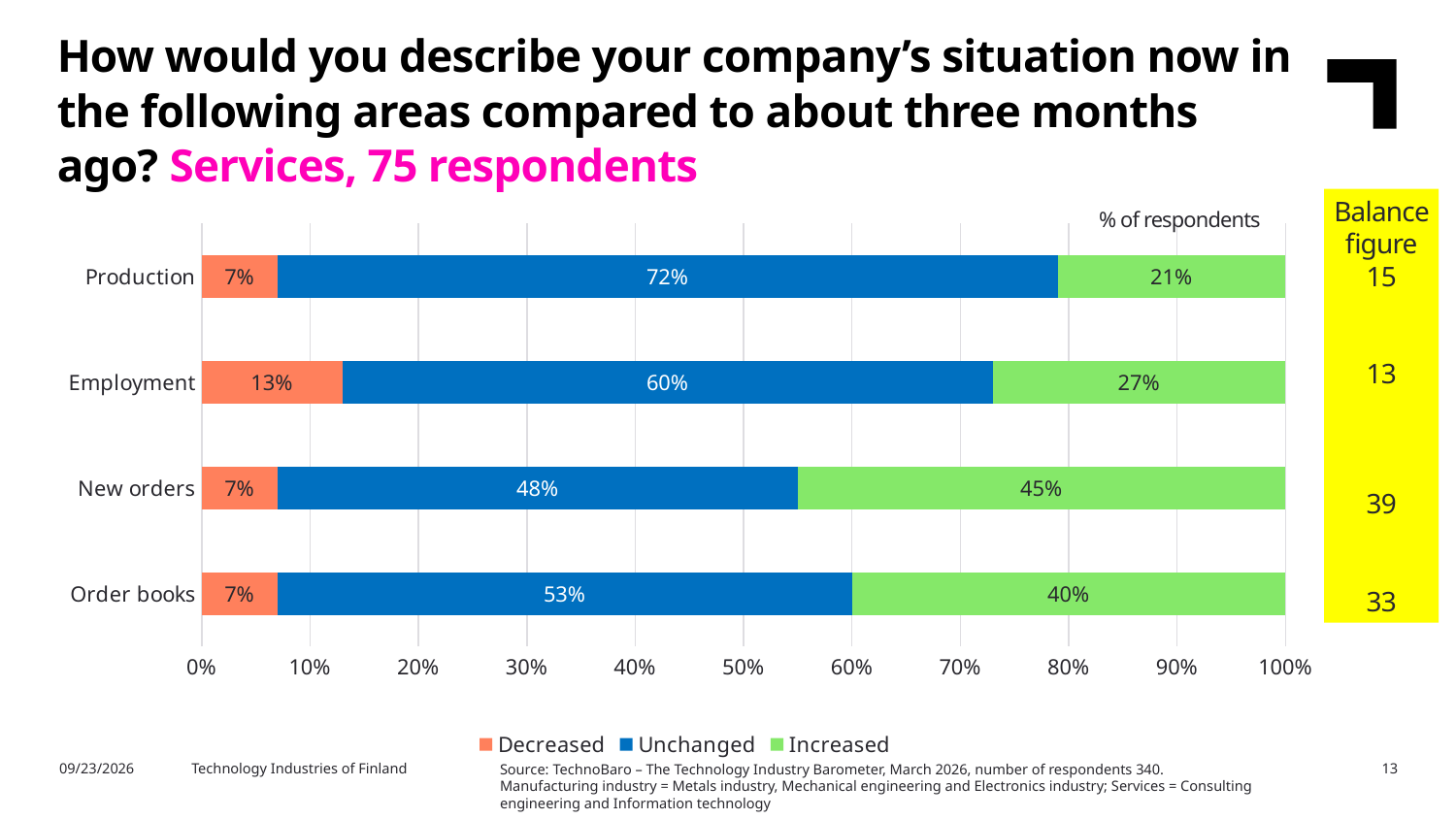
What is the balance figure shown for New orders? 39 What percentage of respondents reported that Order books were unchanged? 53% Which category has the lowest share of respondents reporting an increase? Production What percentage of respondents reported that New orders increased? 45% Which is larger: the Unchanged share for Employment or the Unchanged share for Order books? Employment What is the difference between the Increased share for New orders and the Increased share for Production? 24% What percentage of respondents reported that Employment decreased? 13% What percentage of respondents reported that Production was unchanged? 72% What kind of chart is shown on the slide? Stacked bar chart Which category has the highest share of respondents reporting an increase? New orders How many categories are shown on the chart? 4 How many series does the legend list? 3